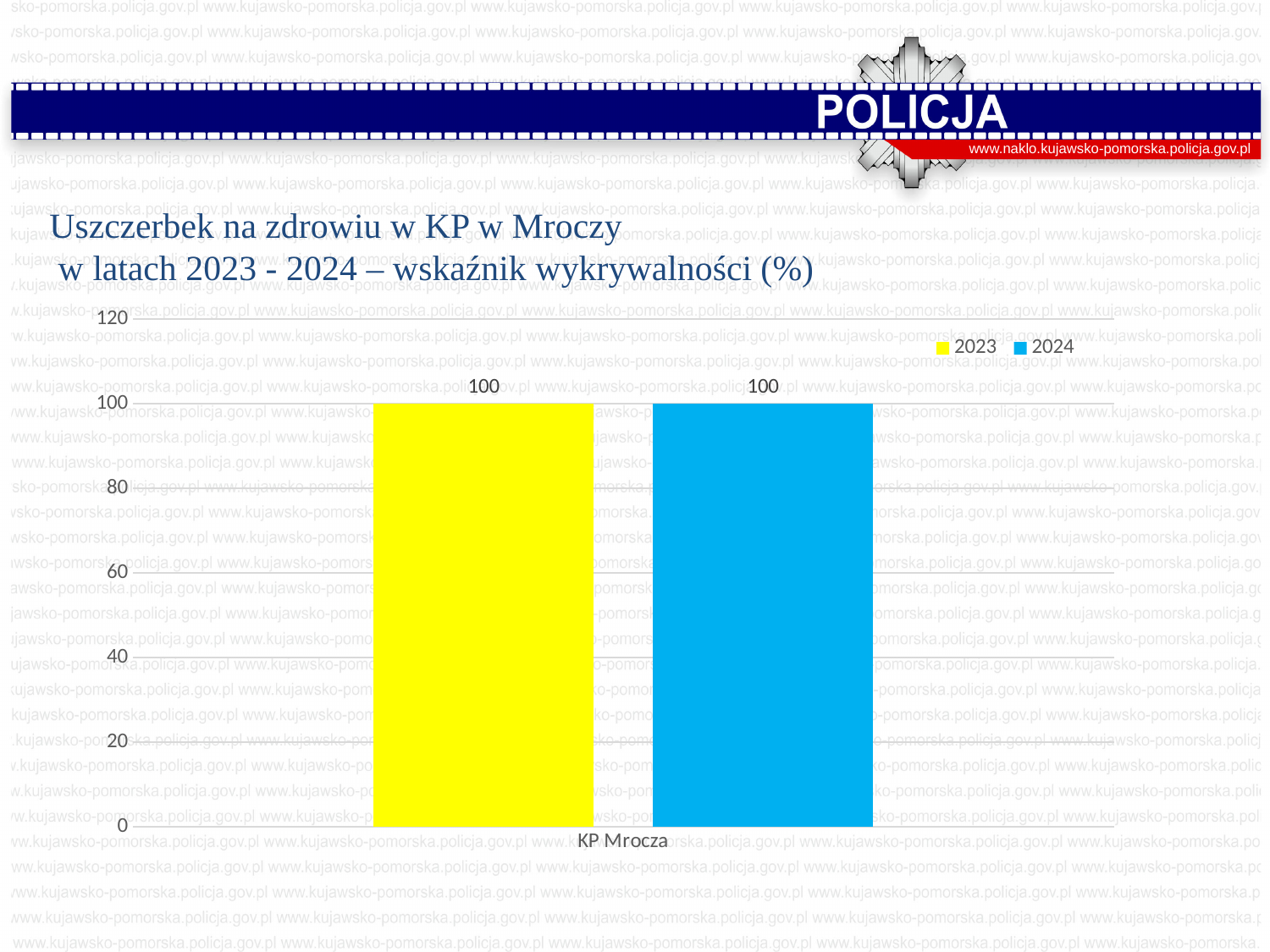
How many categories are shown on the x axis of the chart? 1 Is the value for 2023 for KP Mrocza greater or less than 80? greater What is the category label shown on the x axis of the chart? KP Mrocza Which colour represents the 2023 series in the chart? yellow What kind of chart is shown on the slide? bar chart What is the difference between the 2023 and 2024 values for KP Mrocza? 0 What is the value for 2024 for KP Mrocza? 100 Is the value for 2024 for KP Mrocza greater or less than 120? less Is the 2024 value for KP Mrocza larger than, smaller than, or equal to the 2023 value? equal How many series does the legend list? 2 What is the value for 2023 for KP Mrocza? 100